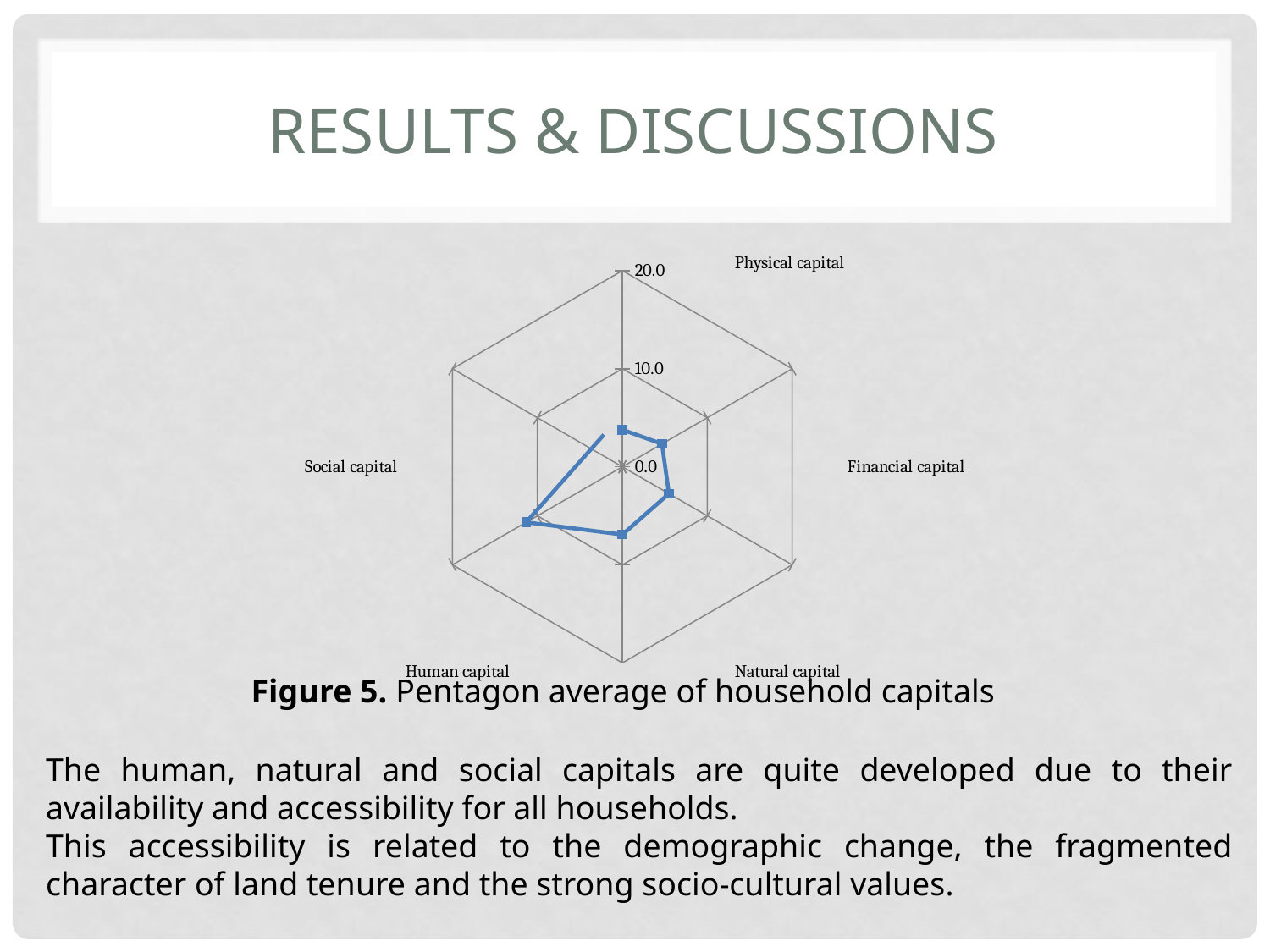
Is the value for Natural capital greater or less than 10.0? less Which is larger, the value for Natural capital or the value for Financial capital? Natural capital How many capital categories are labelled on the chart? 5 Which labelled capital has the highest value on the chart? Social capital Is the value for Human capital greater or less than 10.0? less Which is larger, the value for Human capital or the value for Social capital? Social capital What is the caption of the chart on the slide? Figure 5. Pentagon average of household capitals What kind of chart is shown in Figure 5? radar chart Which is larger, the value for Human capital or the value for Physical capital? Human capital What is the highest value shown on the chart's axis scale? 20.0 Is the value for Physical capital greater or less than 10.0? less